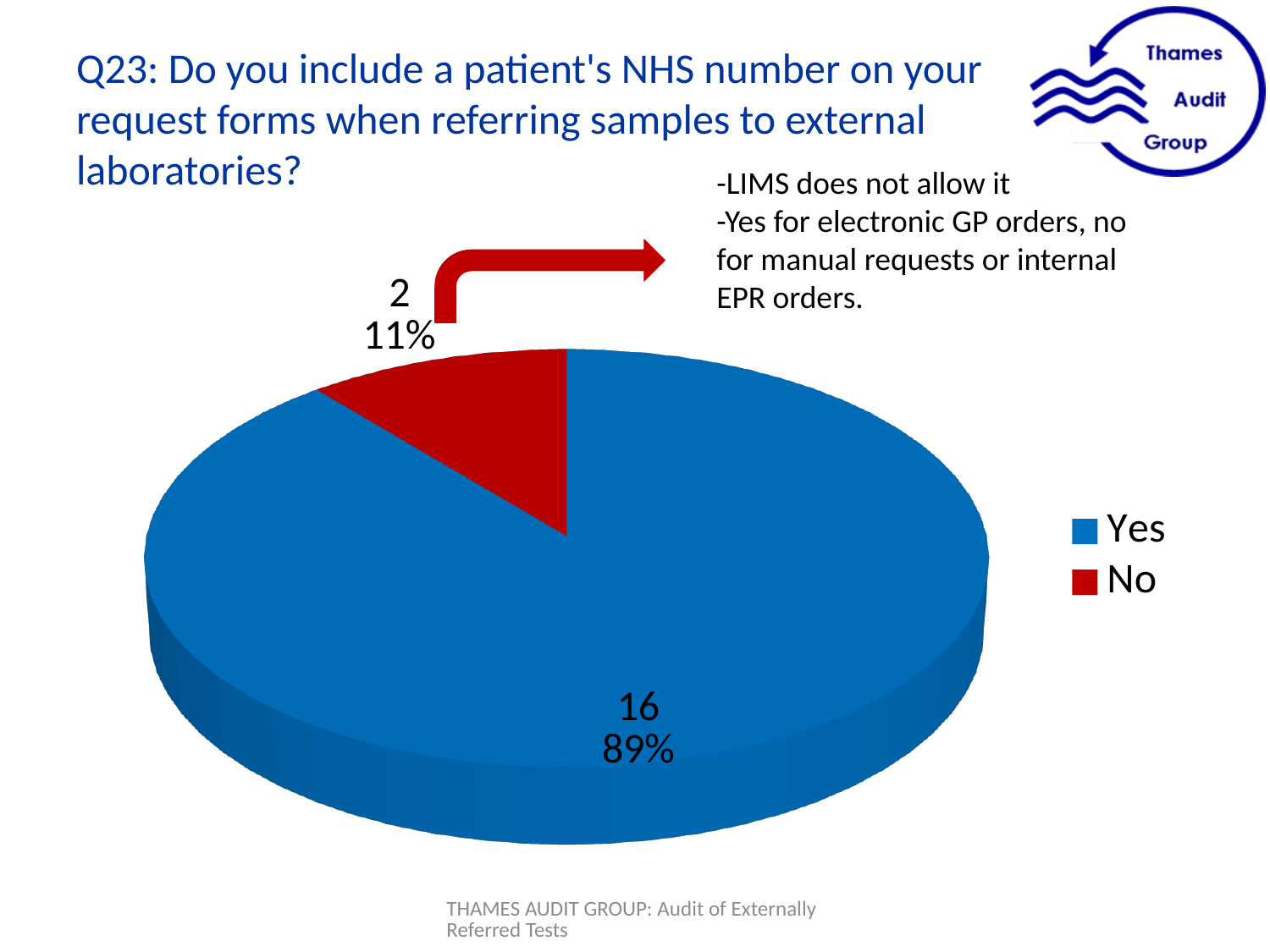
What colour is the No slice of the pie? red How many categories does the legend list? 2 What percentage of the pie does the No slice represent? 11% Which slice is larger, Yes or No? Yes What percentage of the pie does the Yes slice represent? 89% Which category has the smallest slice of the pie? No What is the difference in count between the Yes and No slices? 14 How many responses are in the No slice? 2 What kind of chart is shown on the slide? pie chart Which category has the largest slice of the pie? Yes How many responses are in the Yes slice? 16 What is the total number of responses shown in the pie chart? 18